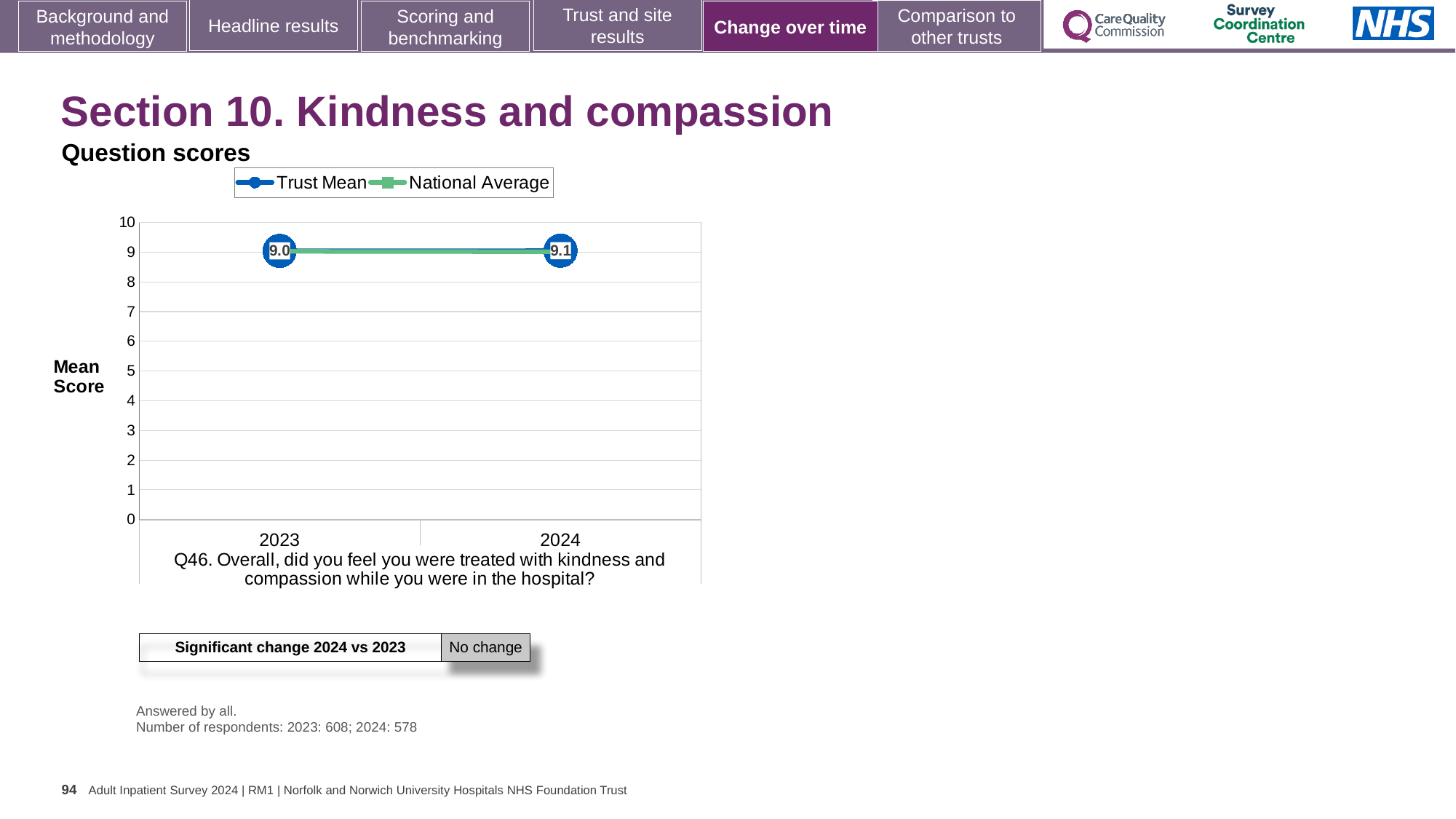
What are the two series named in the legend? Trust Mean and National Average What kind of chart is shown? line chart Is the Trust Mean for 2023 greater or less than 8? greater What is the Trust Mean for 2024? 9.1 Which year has the higher Trust Mean, 2023 or 2024? 2024 Is the National Average for 2024 greater or less than 5? greater What is the label on the y axis? Mean Score By how much did the Trust Mean change from 2023 to 2024? 0.1 What is the Trust Mean for 2023? 9.0 How many series does the legend list? 2 Does the Trust Mean rise or fall from 2023 to 2024? rise How many years are shown on the x axis? 2